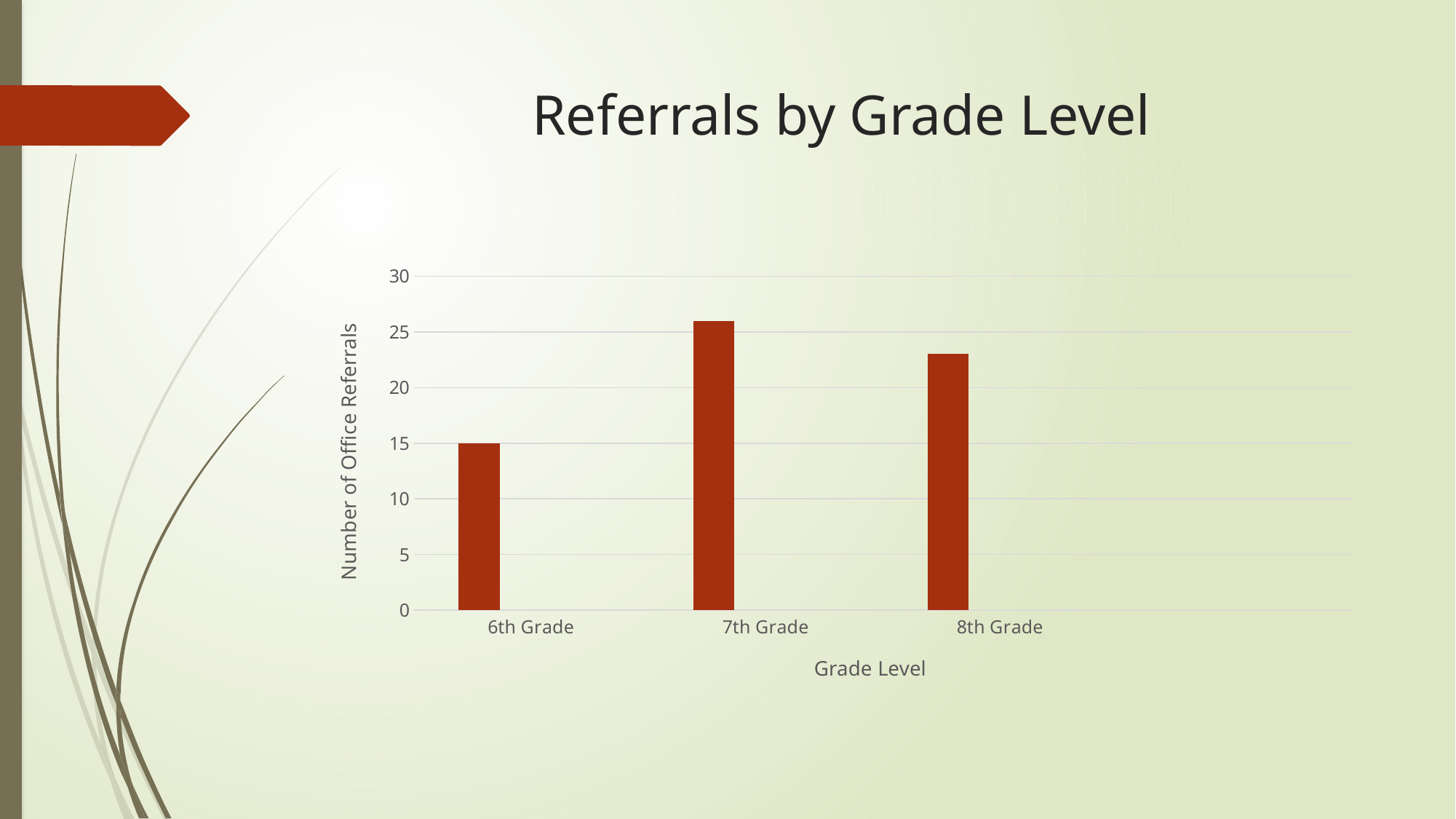
What is the title of the chart? Referrals by Grade Level Which has fewer office referrals, 6th Grade or 8th Grade? 6th Grade Which grade level has the highest number of office referrals? 7th Grade Which has more office referrals, 7th Grade or 8th Grade? 7th Grade What type of chart is shown on the slide? bar chart Which grade level has the lowest number of office referrals? 6th Grade What is the label of the vertical axis? Number of Office Referrals How many grade levels are shown on the x axis? 3 What is the number of office referrals for 6th Grade? 15 Is the value for 8th Grade greater or less than 20? greater Is the value for 7th Grade greater or less than 25? greater Is the value for 8th Grade greater or less than 25? less